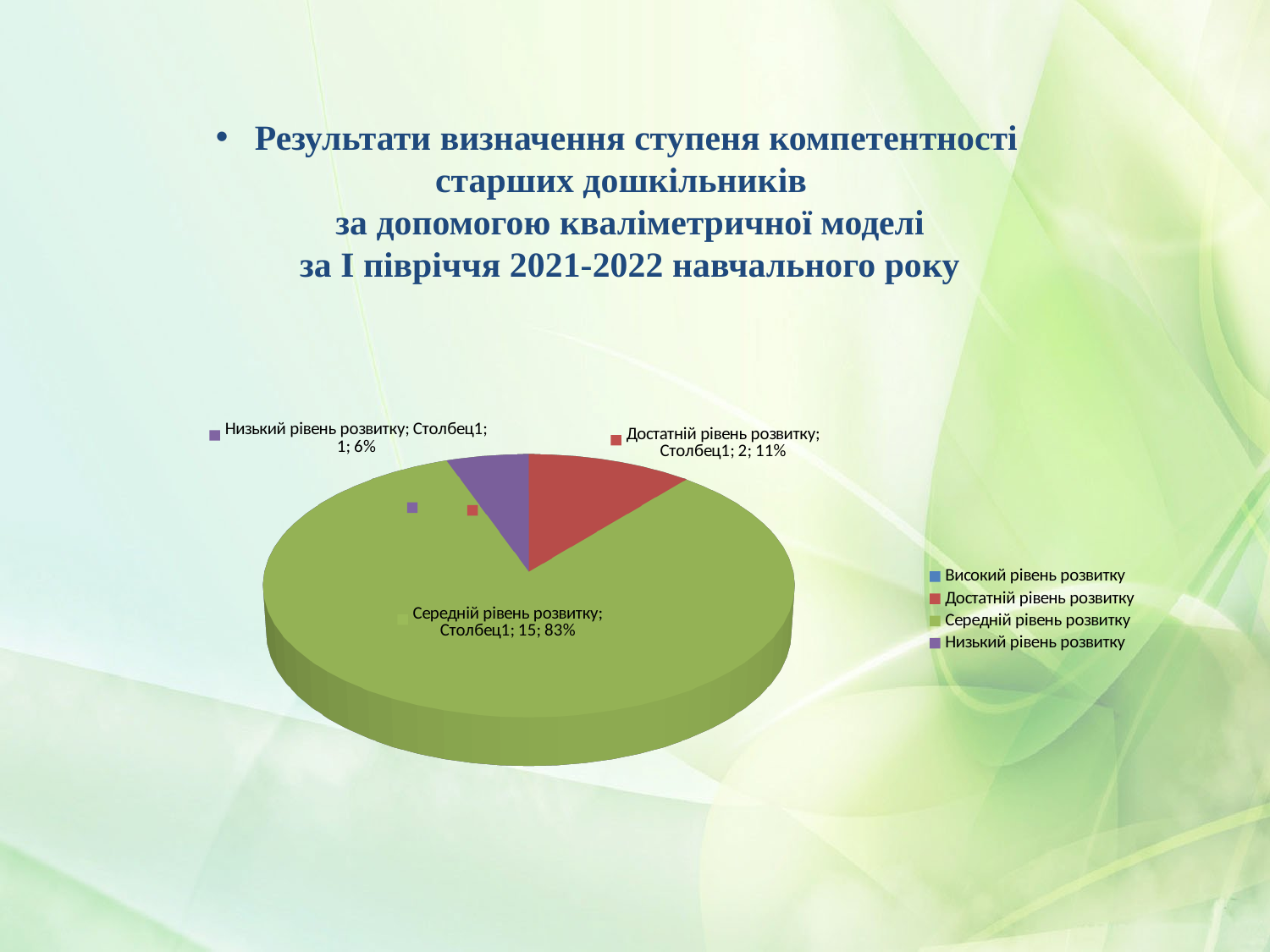
What percentage share does Низький рівень розвитку have in the pie? 6% What kind of chart is shown on the slide? pie chart Which is larger, the value for Достатній рівень розвитку or the value for Низький рівень розвитку? Достатній рівень розвитку What value is shown for Низький рівень розвитку? 1 How many entries does the legend list? 4 What percentage share does Достатній рівень розвитку have in the pie? 11% What value is shown for Середній рівень розвитку? 15 What value is shown for Достатній рівень розвитку? 2 Which category has the largest slice of the pie? Середній рівень розвитку What percentage share does Середній рівень розвитку have in the pie? 83% Which of the labelled slices is the smallest? Низький рівень розвитку What is the difference between the values for Середній рівень розвитку and Достатній рівень розвитку? 13